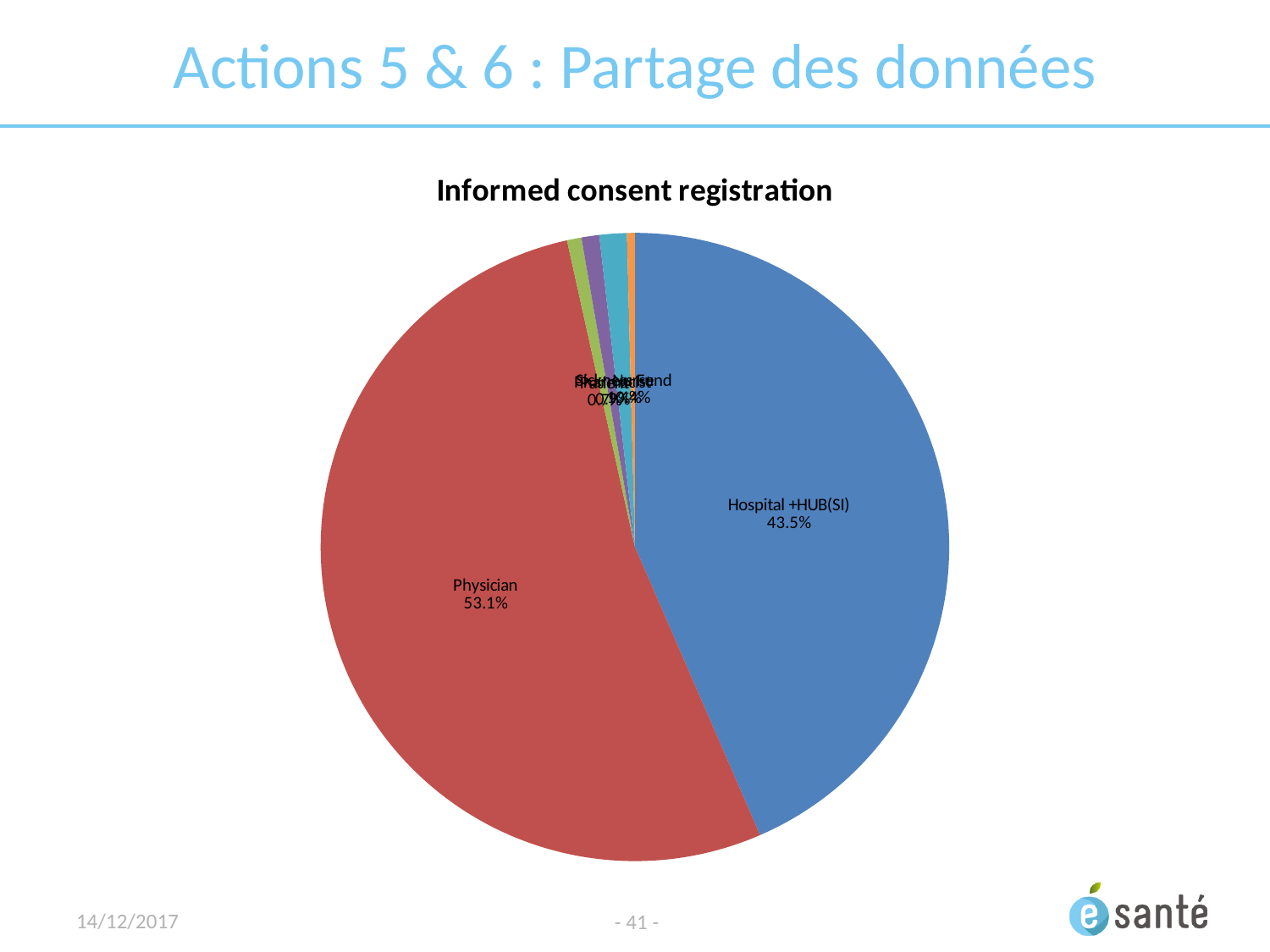
What colour is the Physician slice? red Which category has the largest slice of the pie? Physician Is the share for Hospital +HUB(SI) greater or less than 50%? less Which is larger, the Physician slice or the Hospital +HUB(SI) slice? Physician What is the difference in percentage points between the Physician slice and the Hospital +HUB(SI) slice? 9.6 What is the combined share of the Physician and Hospital +HUB(SI) slices? 96.6% What is the title of the chart? Informed consent registration What type of chart is shown on the slide? pie chart What share of the pie does Hospital +HUB(SI) represent? 43.5% Is the share for Physician greater or less than 50%? greater What share of the pie does Physician represent? 53.1%